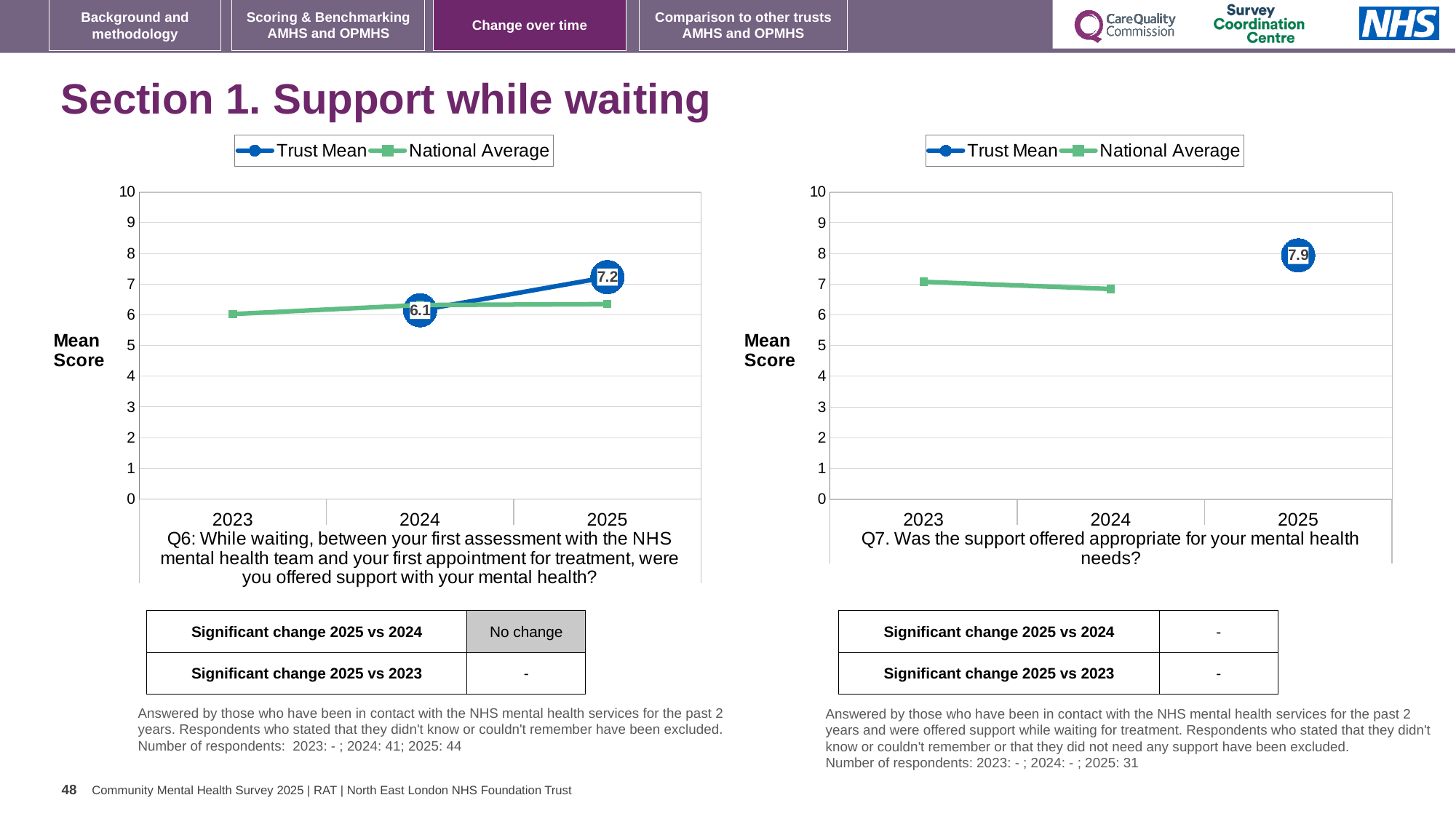
How many years are shown on the x axis of the Q7 chart on the right? 3 How many series does the legend of the Q6 chart on the left list? 2 What are the two legend entries in the Q6 chart on the left? Trust Mean and National Average In the Q6 chart on the left, by how much did the Trust Mean change from 2024 to 2025? 1.1 In the Q6 chart on the left, what is the Trust Mean score for 2024? 6.1 In the Q6 chart on the left, what is the Trust Mean score for 2025? 7.2 In the Q6 chart on the left, which is higher in 2025, the Trust Mean or the National Average? Trust Mean In the Q6 chart on the left, does the Trust Mean rise or fall from 2024 to 2025? rise In the Q7 chart on the right, does the National Average rise or fall from 2023 to 2024? fall In the Q7 chart on the right, what is the Trust Mean score for 2025? 7.9 What type of chart is used for the Q7 chart on the right? line chart In the Q6 chart on the left, is the National Average value for 2023 greater or less than 5? greater